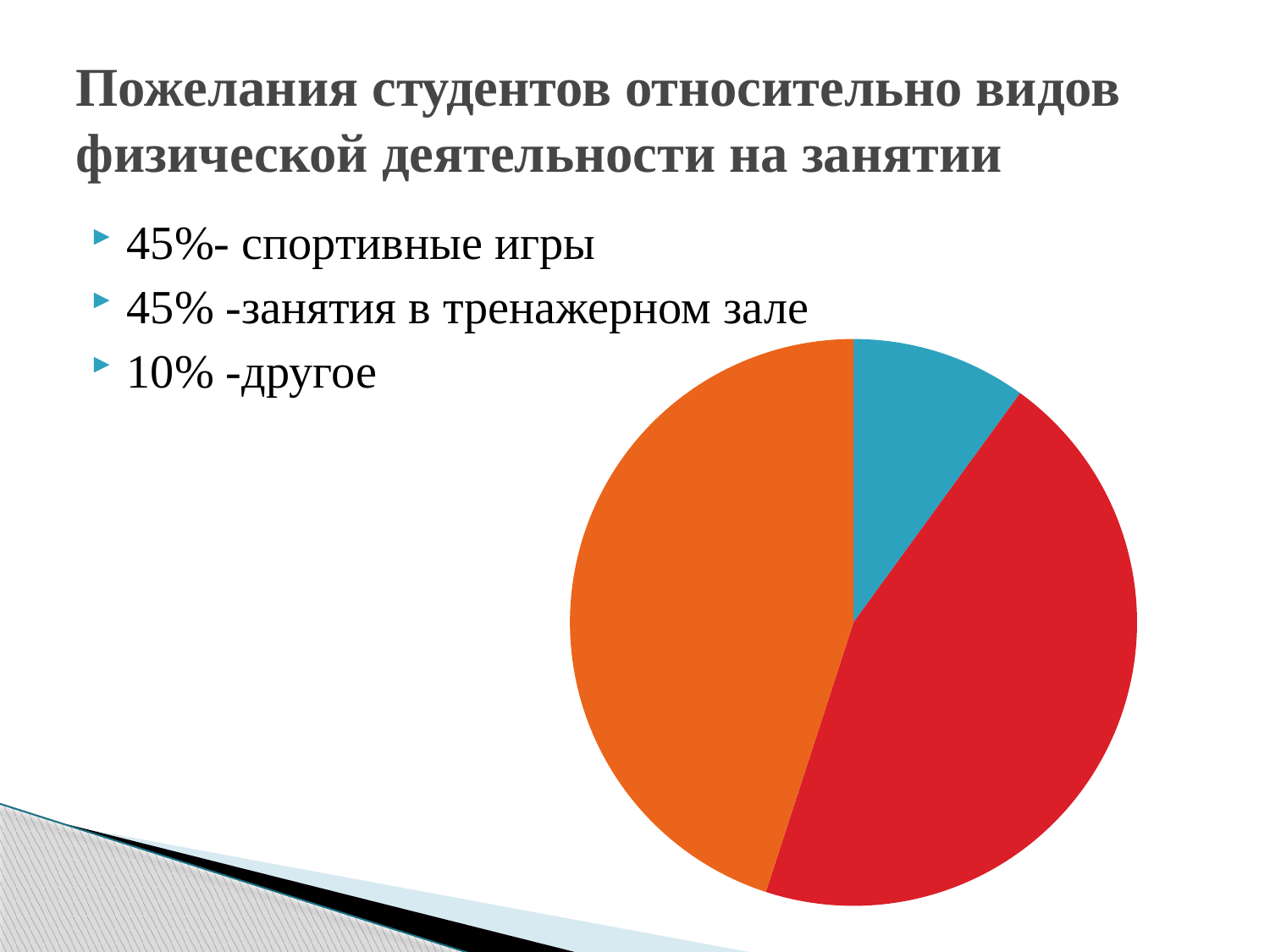
What share of students chose спортивные игры? 45% What colour is the smallest slice of the pie chart? blue What is the title of the slide containing the pie chart? Пожелания студентов относительно видов физической деятельности на занятии How many slices does the pie chart have? 3 Which is larger: the share for спортивные игры or the share for другое? спортивные игры Which category has the smallest share of the pie? другое What kind of chart is shown on the slide? pie chart What do the three shares listed on the slide add up to? 100% What share of students chose занятия в тренажерном зале? 45% What is the difference between the share for занятия в тренажерном зале and the share for другое? 35% What share of students chose другое? 10%